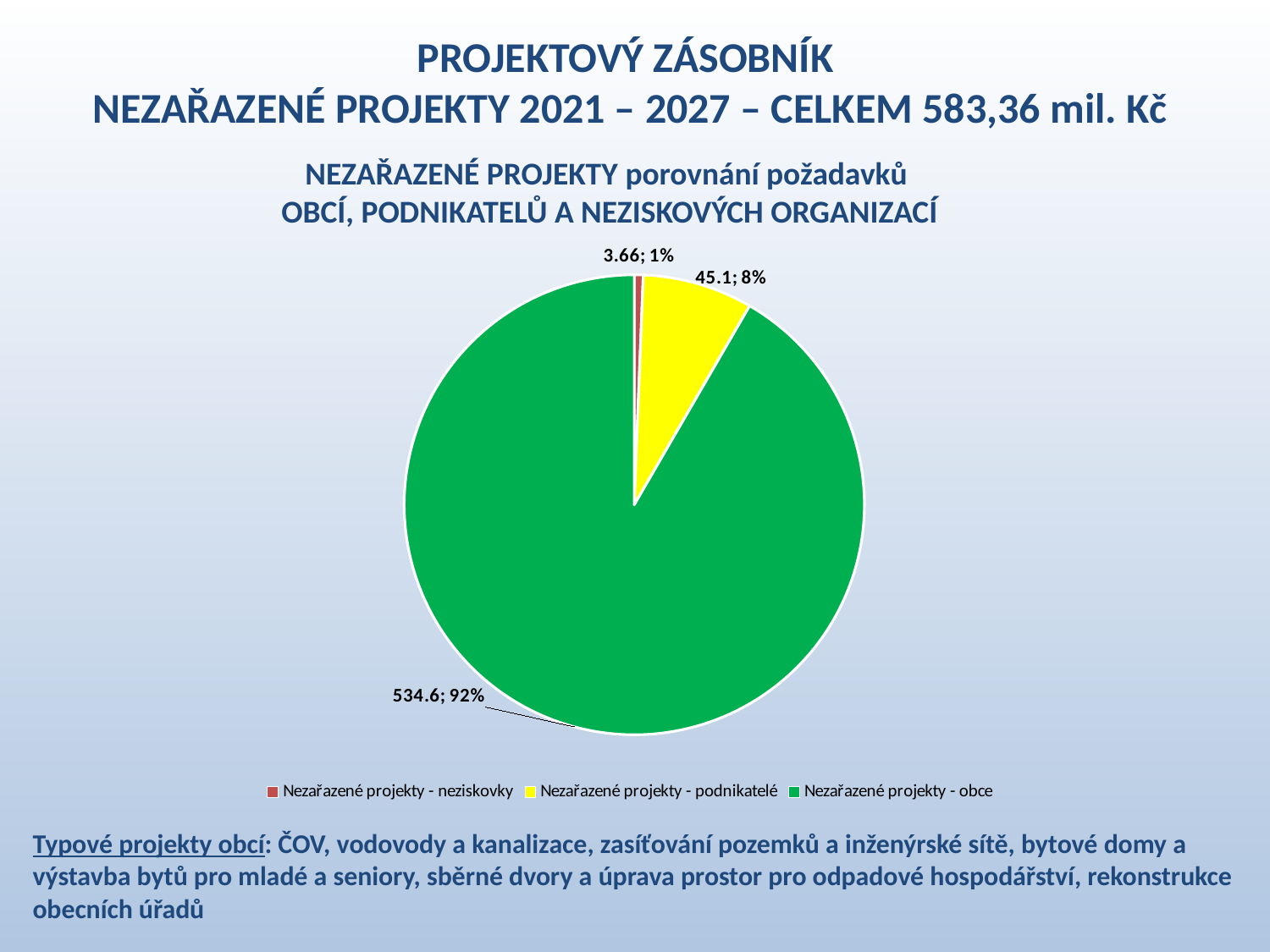
Which category has the smallest slice of the pie? Nezařazené projekty - neziskovky Which category has the largest slice of the pie? Nezařazené projekty - obce How many entries does the legend of the pie chart list? 3 What share of the pie does 'Nezařazené projekty - podnikatelé' represent? 8% What is the difference between the values for 'Nezařazené projekty - podnikatelé' and 'Nezařazené projekty - neziskovky'? 41.44 What value is shown for 'Nezařazené projekty - neziskovky'? 3.66 Which colour represents 'Nezařazené projekty - podnikatelé' in the pie chart? yellow How many slices does the pie chart have? 3 What value is shown for 'Nezařazené projekty - podnikatelé'? 45.1 What kind of chart is shown on the slide? pie chart What share of the pie does 'Nezařazené projekty - obce' represent? 92% What value is shown for 'Nezařazené projekty - obce'? 534.6